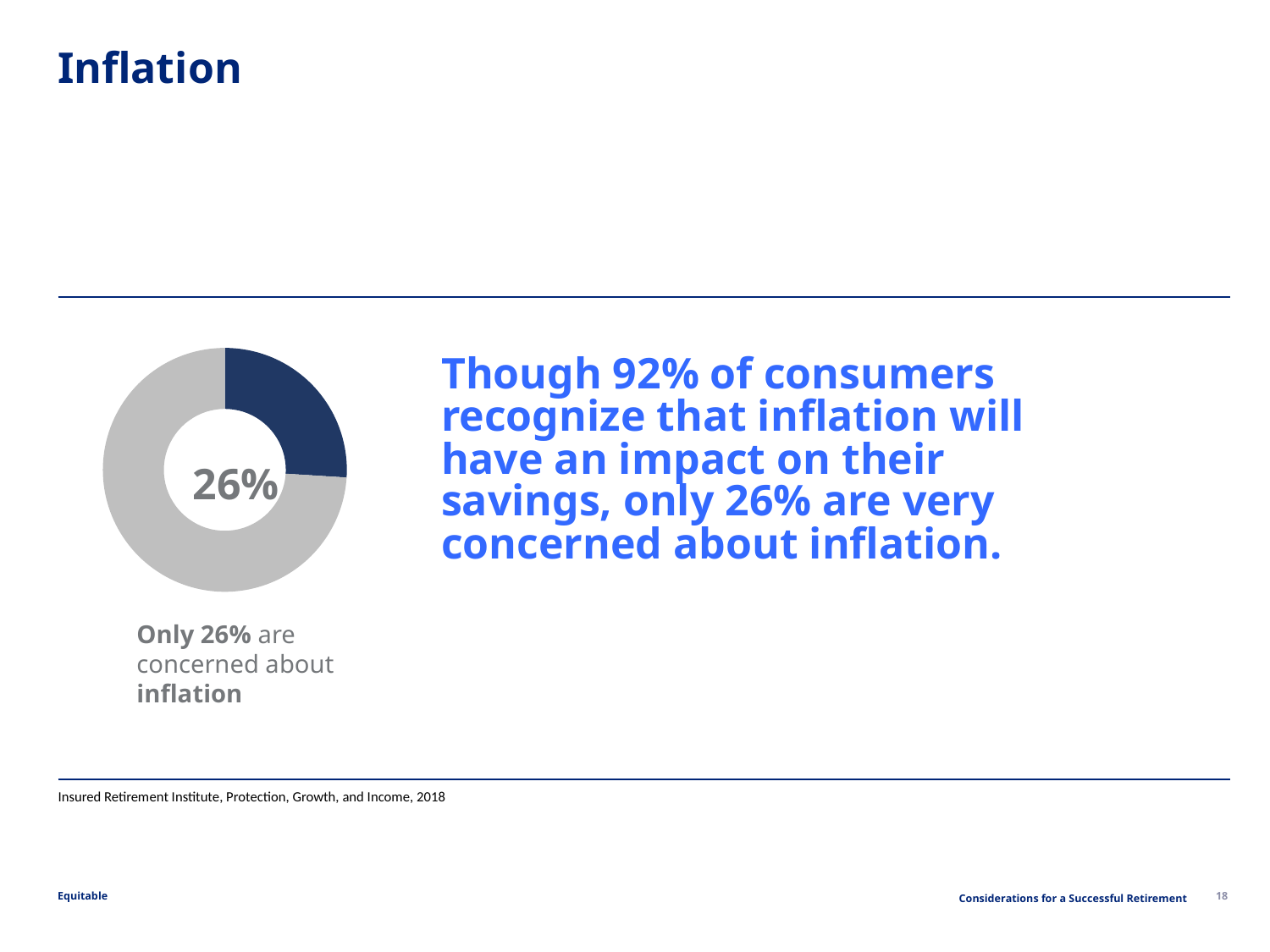
How many slices does the donut chart have? 2 What colour is the slice representing the 26% who are concerned about inflation? dark blue What percentage is printed in the centre of the donut chart? 26% Which slice of the donut chart is larger, the dark blue slice or the grey slice? grey What kind of chart is shown on the slide? pie chart (donut) What does the caption below the donut chart say? Only 26% are concerned about inflation What share of consumers are concerned about inflation, according to the donut chart? 26% Is the share of consumers concerned about inflation greater or less than 50%? less